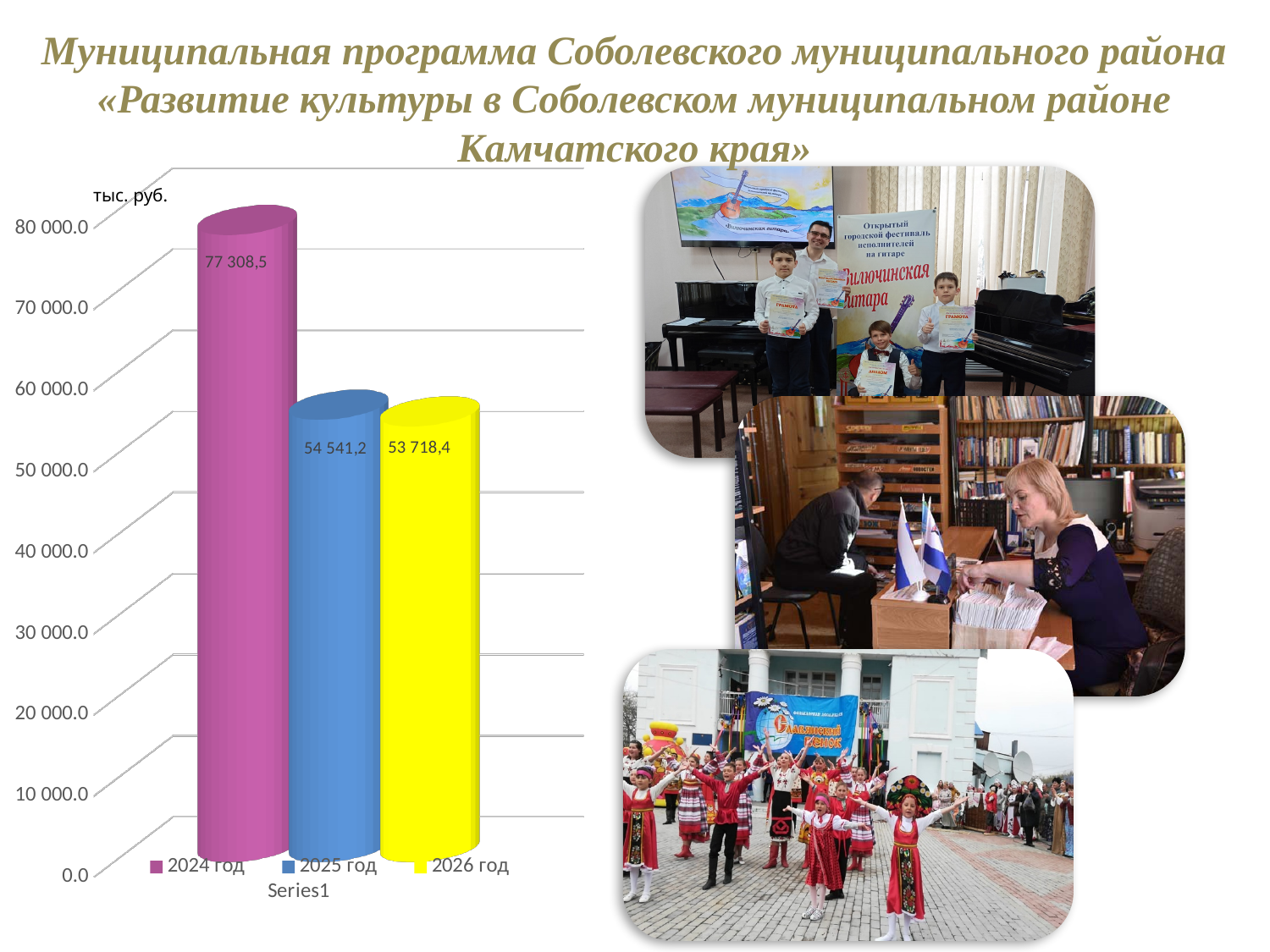
What is the value for 2024 год? 77 308,5 What is the difference between the values for 2024 год and 2025 год? 22 767,3 Is the value for 2024 год greater or less than 70 000.0? greater What is the value for 2025 год? 54 541,2 Which is larger, the value for 2025 год or 2026 год? 2025 год What kind of chart is shown on the slide? bar chart Which year has the lowest value? 2026 год What unit is shown above the vertical axis of the chart? тыс. руб. What is the value for 2026 год? 53 718,4 Which year has the highest value? 2024 год How many series does the legend list? 3 What is the difference between the values for 2025 год and 2026 год? 822,8